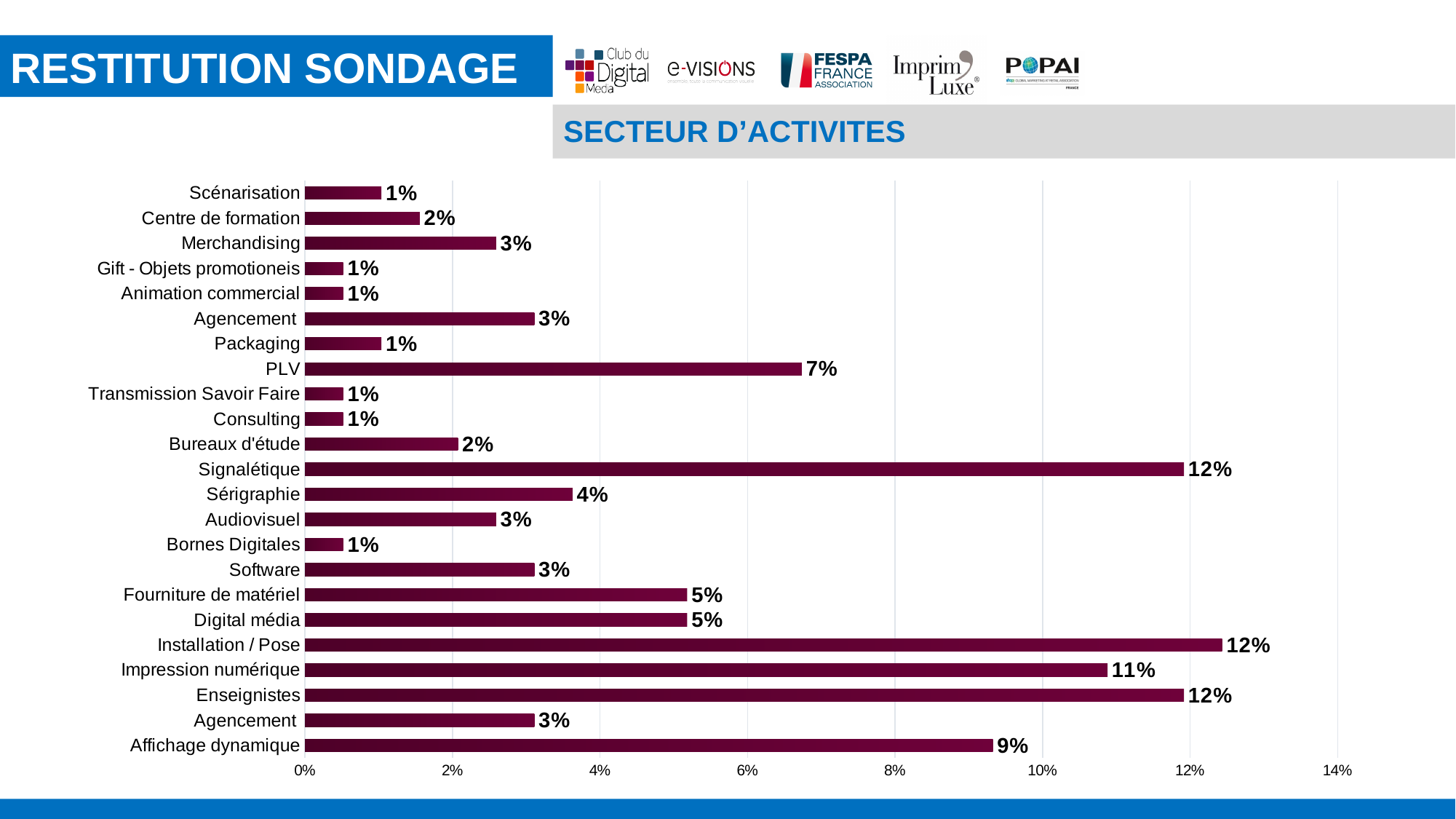
What is the value for Sérigraphie? 4% What is the value for Fourniture de matériel? 5% How many categories are shown in the chart? 23 What is the value for PLV? 7% Which is larger, the value for PLV or the value for Affichage dynamique? Affichage dynamique What is the value for Affichage dynamique? 9% What kind of chart is shown on the slide? Bar chart What is the value for Merchandising? 3% What is the value for Impression numérique? 11% What is the difference between the values for Affichage dynamique and PLV? 2% What is the difference between the values for Impression numérique and Sérigraphie? 7% Is the value for Affichage dynamique greater or less than 8%? greater